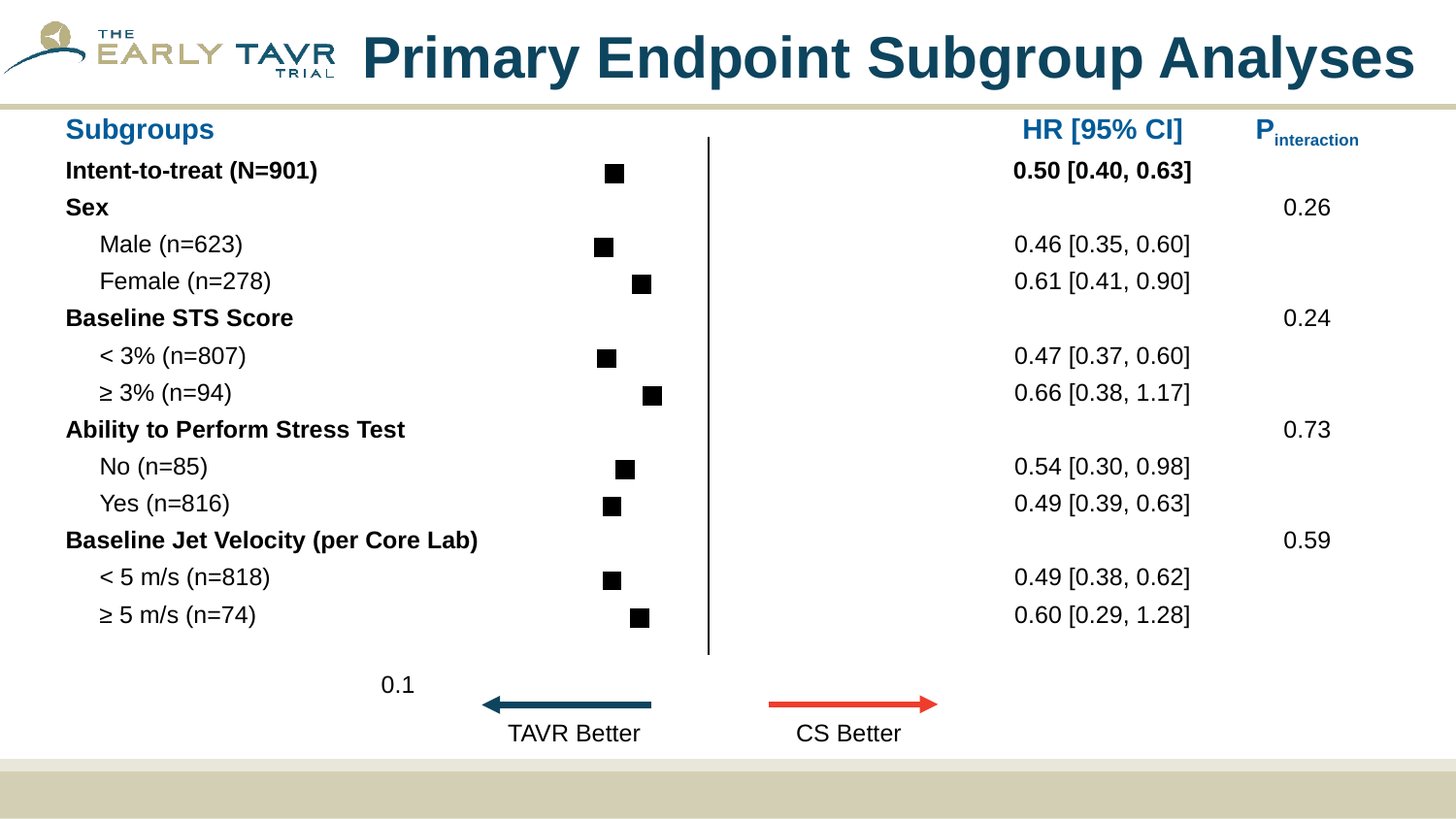
What is the P interaction value for Ability to Perform Stress Test? 0.73 What is the HR [95% CI] for the Female (n=278) subgroup? 0.61 [0.41, 0.90] What is the HR [95% CI] for the ≥ 3% Baseline STS Score subgroup (n=94)? 0.66 [0.38, 1.17] How many hazard ratio point estimates are plotted on the chart? 9 Which subgroup has the lowest hazard ratio point estimate? Male (n=623) Which subgroup has the highest hazard ratio point estimate? ≥ 3% (n=94) What is the P interaction value for Sex? 0.26 What is the hazard ratio with 95% CI for the Intent-to-treat (N=901) group? 0.50 [0.40, 0.63] What is the difference between the hazard ratio point estimates for Female (n=278) and Male (n=623)? 0.15 What kind of chart is shown on the slide? Forest plot What does the arrow pointing to the left on the chart indicate? TAVR Better Which has the larger hazard ratio point estimate, ≥ 5 m/s (n=74) or < 5 m/s (n=818)? ≥ 5 m/s (n=74)